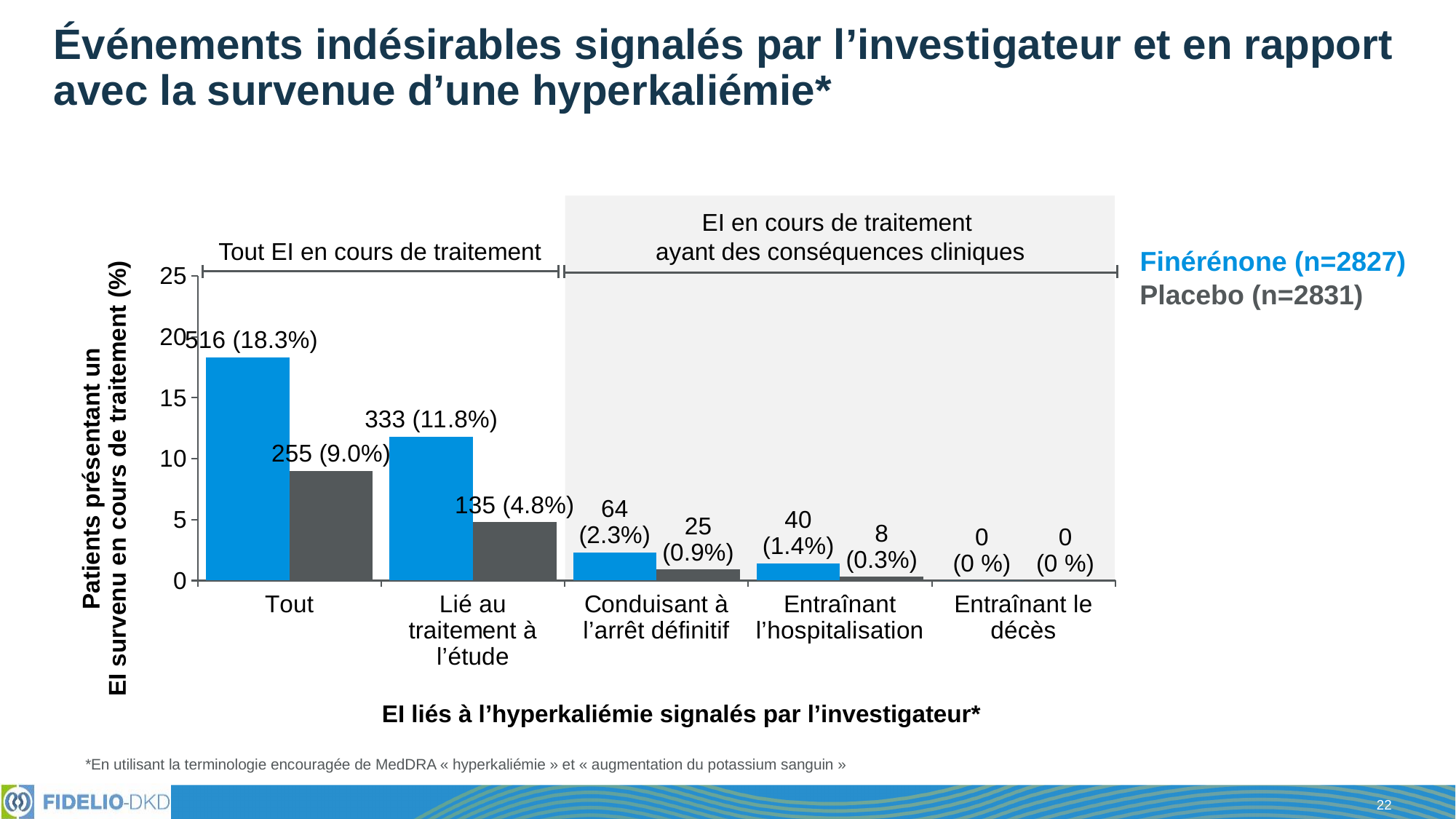
Which is larger in the 'Lié au traitement à l'étude' category, the Finérénone value or the Placebo value? Finérénone What is the data label for Finérénone in the 'Lié au traitement à l'étude' category? 333 (11.8%) How many series does the chart's legend list? 2 What is the data label for Finérénone in the 'Tout' category? 516 (18.3%) Which category has the lowest Placebo value? Entraînant le décès What is the data label for Finérénone in the 'Entraînant l'hospitalisation' category? 40 (1.4%) How many categories are shown on the x axis of the chart? 5 Which category has the highest Finérénone value? Tout What is the data label for Placebo in the 'Conduisant à l'arrêt définitif' category? 25 (0.9%) What is the difference in percentage points between Finérénone (18.3%) and Placebo (9.0%) in the 'Tout' category? 9.3 What kind of chart is shown on the slide? Bar chart What is the data label for Placebo in the 'Tout' category? 255 (9.0%)